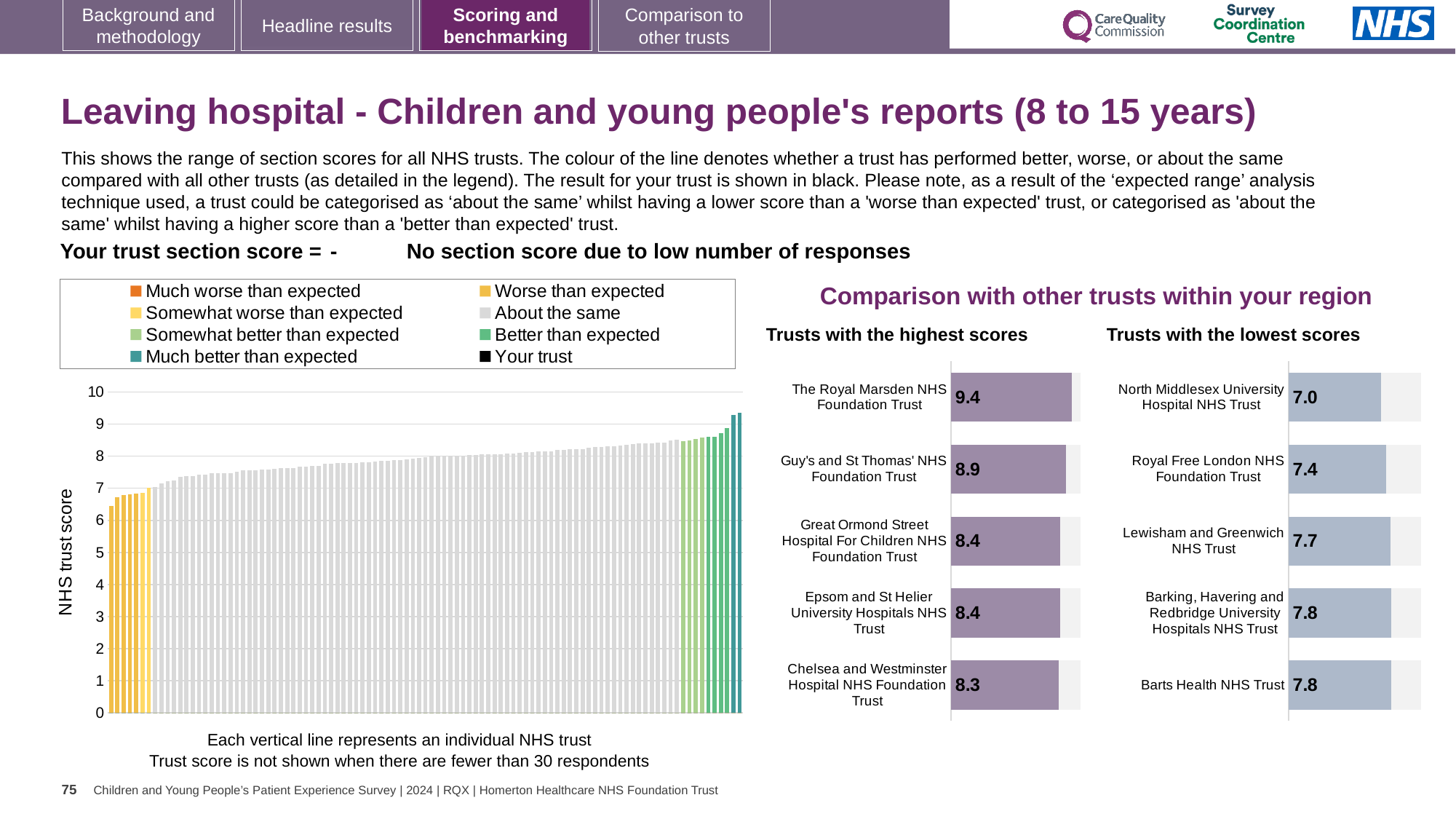
In the 'Trusts with the highest scores' chart, what is the difference between the scores of The Royal Marsden NHS Foundation Trust and Guy's and St Thomas' NHS Foundation Trust? 0.5 In the 'Trusts with the lowest scores' chart, which trust has the lowest score? North Middlesex University Hospital NHS Trust What kind of chart is the NHS trust score chart on the left of the slide? Bar chart In the 'Trusts with the lowest scores' chart, what is the score for North Middlesex University Hospital NHS Trust? 7.0 Which has a higher score: Lewisham and Greenwich NHS Trust in the 'Trusts with the lowest scores' chart or Chelsea and Westminster Hospital NHS Foundation Trust in the 'Trusts with the highest scores' chart? Chelsea and Westminster Hospital NHS Foundation Trust How many trusts are listed in the 'Trusts with the lowest scores' chart? 5 In the NHS trust score chart on the left, do the bar values rise or fall from left to right? Rise In the 'Trusts with the highest scores' chart, which trust has the lowest score shown? Chelsea and Westminster Hospital NHS Foundation Trust In the 'Trusts with the highest scores' chart, what is the score for The Royal Marsden NHS Foundation Trust? 9.4 In the NHS trust score chart on the left, is the value of the tallest bar greater or less than 9? greater How many entries does the legend of the NHS trust score chart list? 8 In the 'Trusts with the lowest scores' chart, what is the difference between the scores of Royal Free London NHS Foundation Trust and North Middlesex University Hospital NHS Trust? 0.4